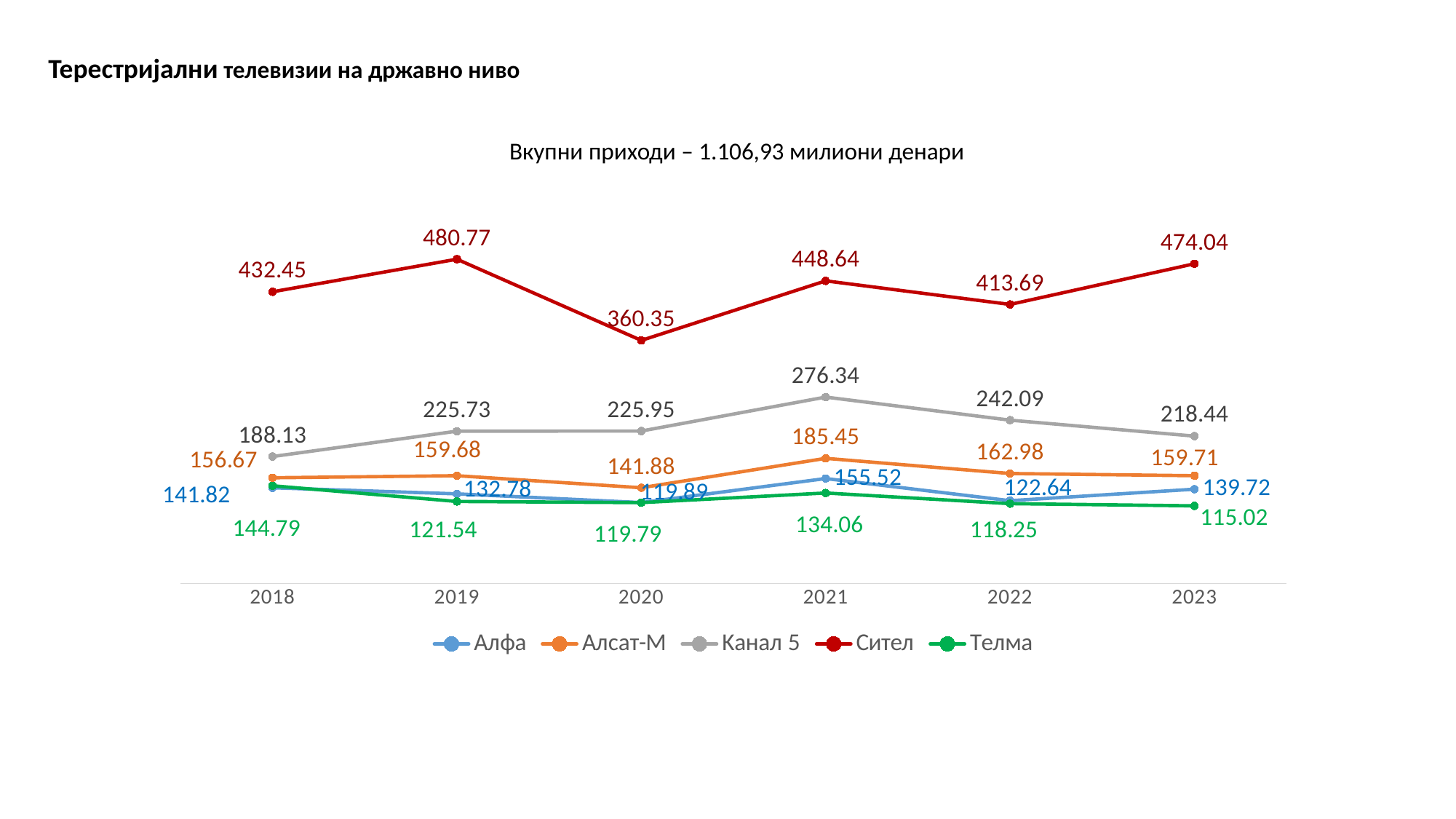
How many series does the legend list? 5 What is the value for Канал 5 in 2021? 276.34 Which is larger in 2020, the value for Алсат-М or the value for Алфа? Алсат-М How many years are shown on the x axis? 6 In which year does Сител have its lowest value? 2020 Does the value for Канал 5 rise or fall from 2021 to 2023? fall What type of chart is shown on the slide? line chart Which series has the highest value in 2021? Сител What is the value for Сител in 2019? 480.77 What is the value for Телма in 2023? 115.02 What is the difference between the Сител values in 2023 and 2022? 60.35 What total revenue figure is stated in the chart title? 1.106,93 милиони денари